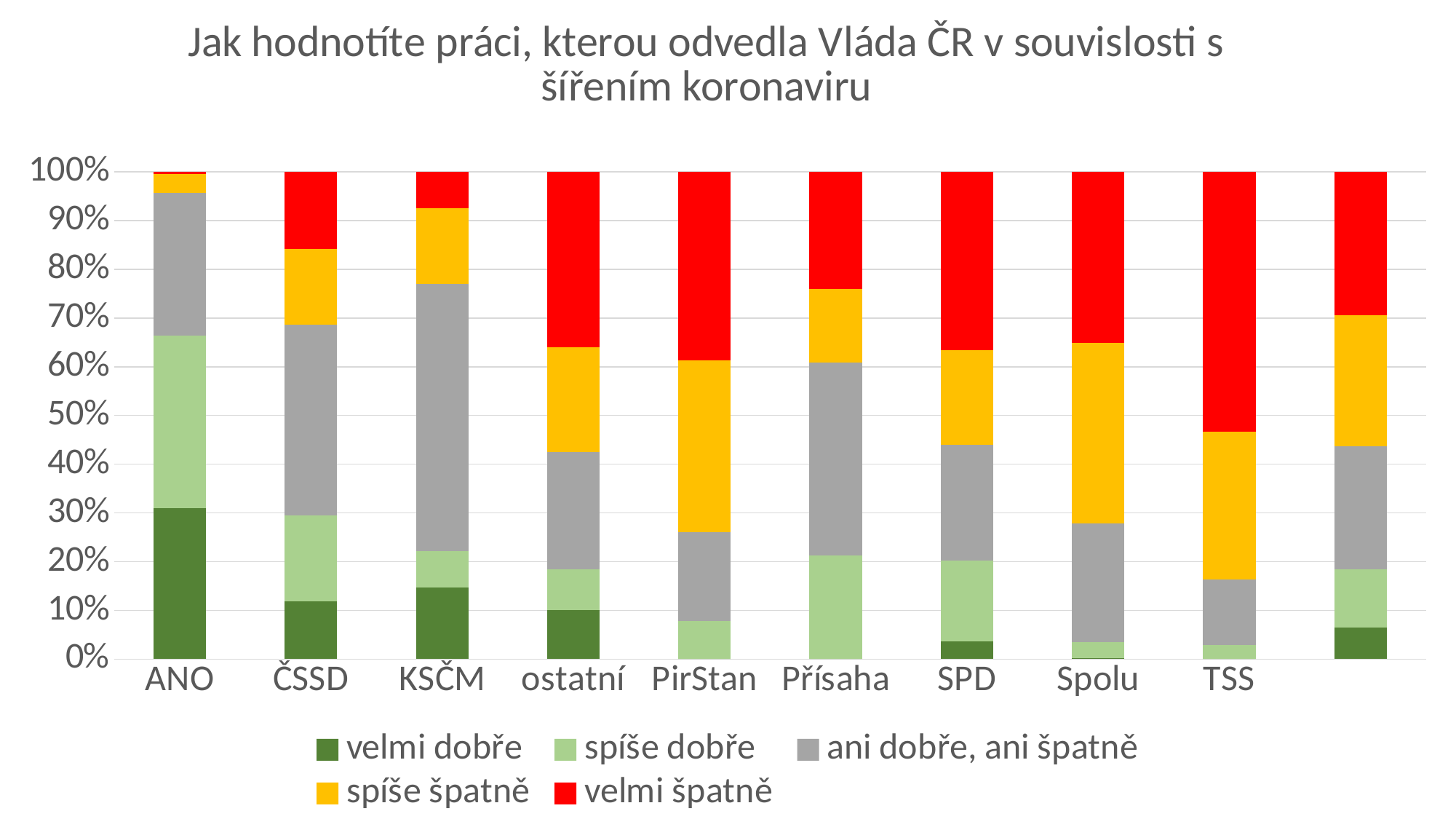
What colour represents 'velmi špatně' in the legend? red Is the 'velmi špatně' share for PirStan greater or less than 30%? greater Which party has the largest 'ani dobře, ani špatně' segment? KSČM What kind of chart is shown on the slide? stacked bar chart Is the 'velmi špatně' share for ANO greater or less than 10%? less Which has a larger 'velmi dobře' share, ANO or ČSSD? ANO Is the 'velmi špatně' share for TSS greater or less than 40%? greater How many series does the legend list? 5 Which party has the largest 'velmi dobře' segment? ANO Which party has the largest 'velmi špatně' segment? TSS Which has a larger 'velmi špatně' share, PirStan or ČSSD? PirStan